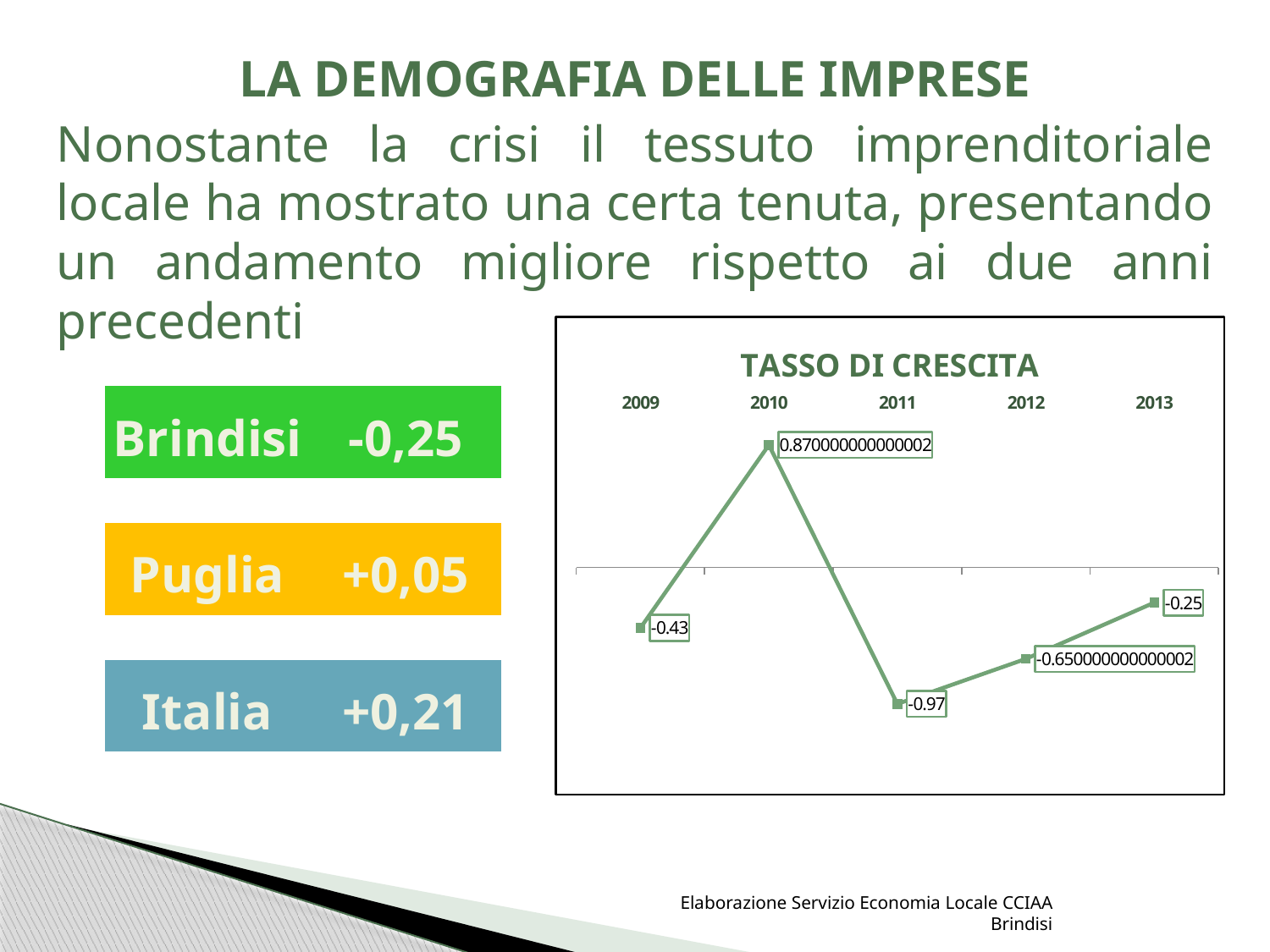
What is the value for 2009 on the TASSO DI CRESCITA chart? -0.43 Which is larger on the TASSO DI CRESCITA chart, the value for 2009 or the value for 2013? 2013 What is the value for 2011 on the TASSO DI CRESCITA chart? -0.97 What is the value for 2013 on the TASSO DI CRESCITA chart? -0.25 Which year has the highest value on the TASSO DI CRESCITA chart? 2010 Which year has the lowest value on the TASSO DI CRESCITA chart? 2011 How many years are plotted on the TASSO DI CRESCITA chart? 5 What type of chart is shown under the title TASSO DI CRESCITA? line chart What is the value for 2010 on the TASSO DI CRESCITA chart, as printed on the data label? 0.870000000000002 What is the difference between the 2009 value and the 2011 value on the TASSO DI CRESCITA chart? 0.54 Do the values on the TASSO DI CRESCITA chart rise or fall from 2011 to 2013? rise What is the title of the chart? TASSO DI CRESCITA